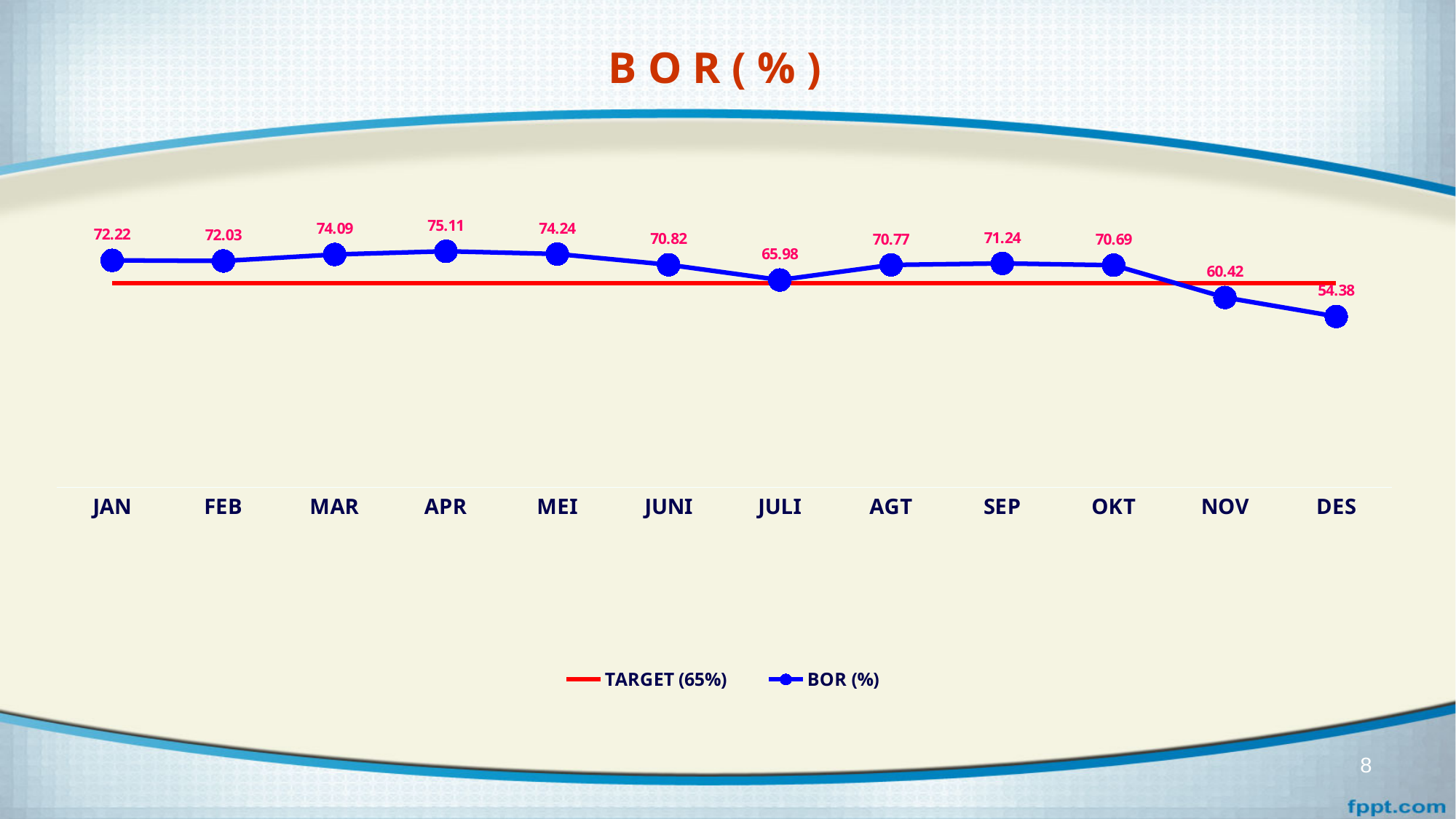
What kind of chart is shown on the slide? Line chart Which month has a larger BOR (%) value, MAR or NOV? MAR How many months are plotted on the x axis? 12 What target value is stated in the legend for the red line? 65% Do the BOR (%) values rise or fall from OKT to DES? Fall What is the difference between the BOR (%) values for APR and DES? 20.73 What is the BOR (%) value for DES? 54.38 Which month has the lowest BOR (%) value? DES What is the BOR (%) value for JULI? 65.98 How many series does the legend list? 2 What is the BOR (%) value for APR? 75.11 Which month has the highest BOR (%) value? APR